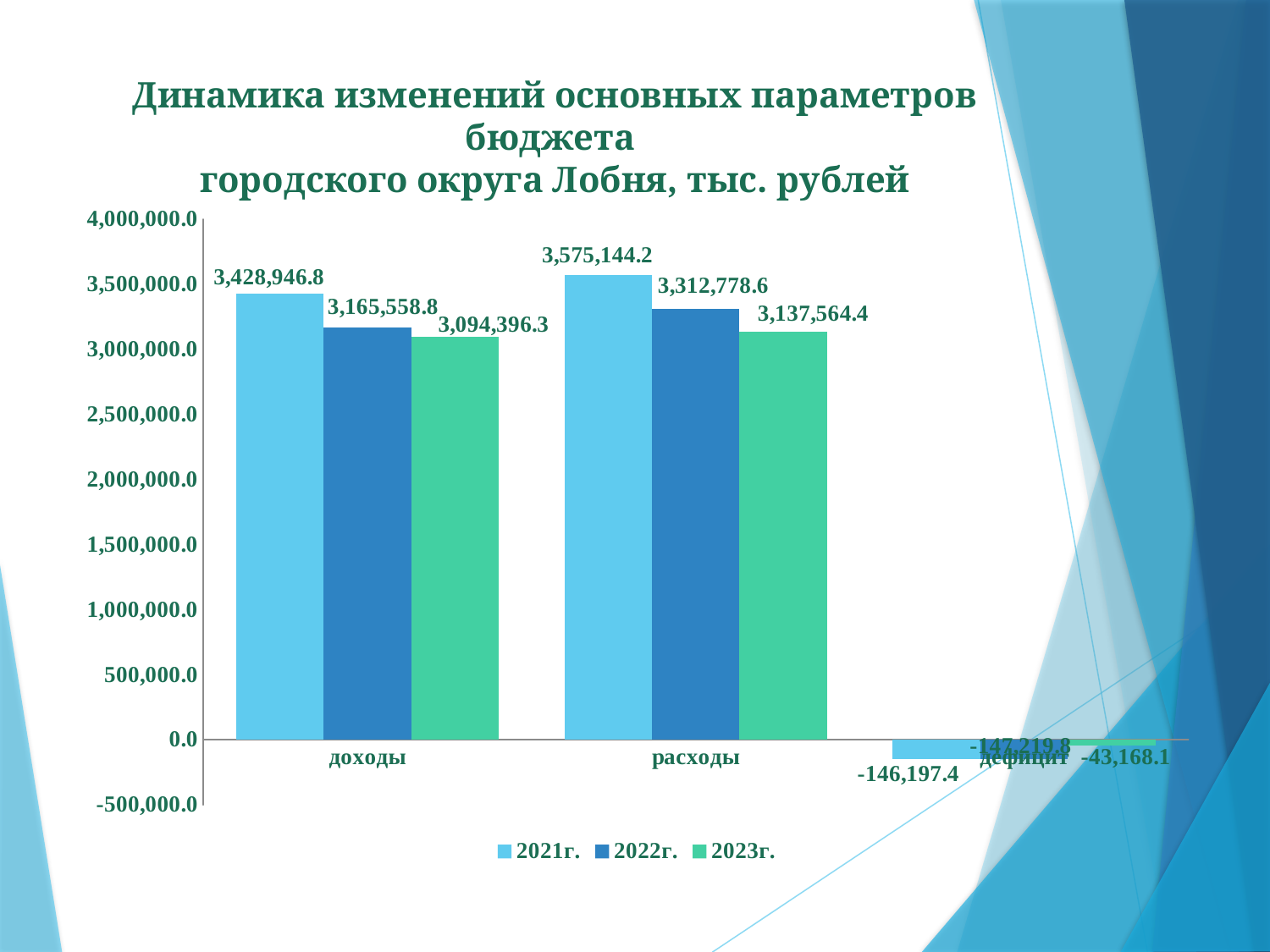
What is the value for доходы in 2022г.? 3,165,558.8 How many series does the legend list? 3 Which year has the lowest value for доходы? 2023г. Do the values for доходы rise or fall from 2021г. to 2023г.? fall Which year has the highest value for расходы? 2021г. What is the difference between расходы and доходы in 2021г.? 146,197.4 What type of chart is shown on the slide? bar chart What is the difference between доходы in 2021г. and доходы in 2022г.? 263,388.0 What is the value for дефицит in 2023г.? -43,168.1 What is the value for доходы in 2021г.? 3,428,946.8 What is the value for расходы in 2023г.? 3,137,564.4 Which is larger: расходы in 2022г. or доходы in 2021г.? доходы in 2021г.